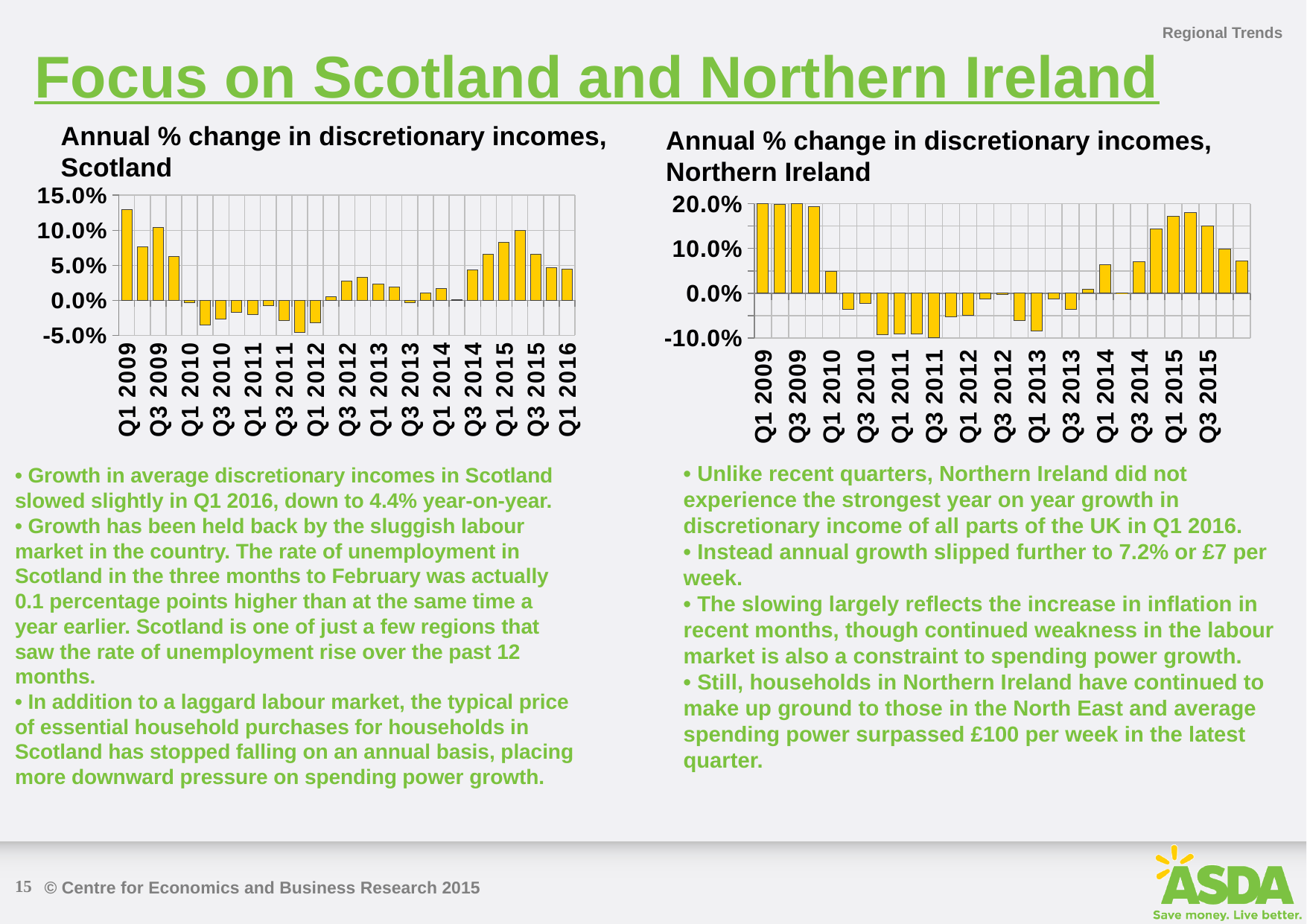
What is the highest value shown on the vertical axis of the Northern Ireland chart? 20.0% In the Northern Ireland chart, is the value for Q1 2011 greater or less than 0.0%? less In the Scotland chart, do the values rise or fall from Q1 2014 to Q1 2015? rise In the Scotland chart, which quarter has the highest annual % change in discretionary incomes? Q1 2009 What is the title of the chart on the right of the slide? Annual % change in discretionary incomes, Northern Ireland In the Northern Ireland chart, is the value for Q1 2009 greater or less than 10.0%? greater In the Scotland chart, which is larger, the value for Q1 2009 or the value for Q1 2015? Q1 2009 In the Scotland chart, is the value for Q1 2009 greater or less than 10.0%? greater In the Northern Ireland chart, which is larger, the value for Q1 2009 or the value for Q1 2015? Q1 2009 What kind of chart is the 'Annual % change in discretionary incomes, Scotland' chart? bar chart